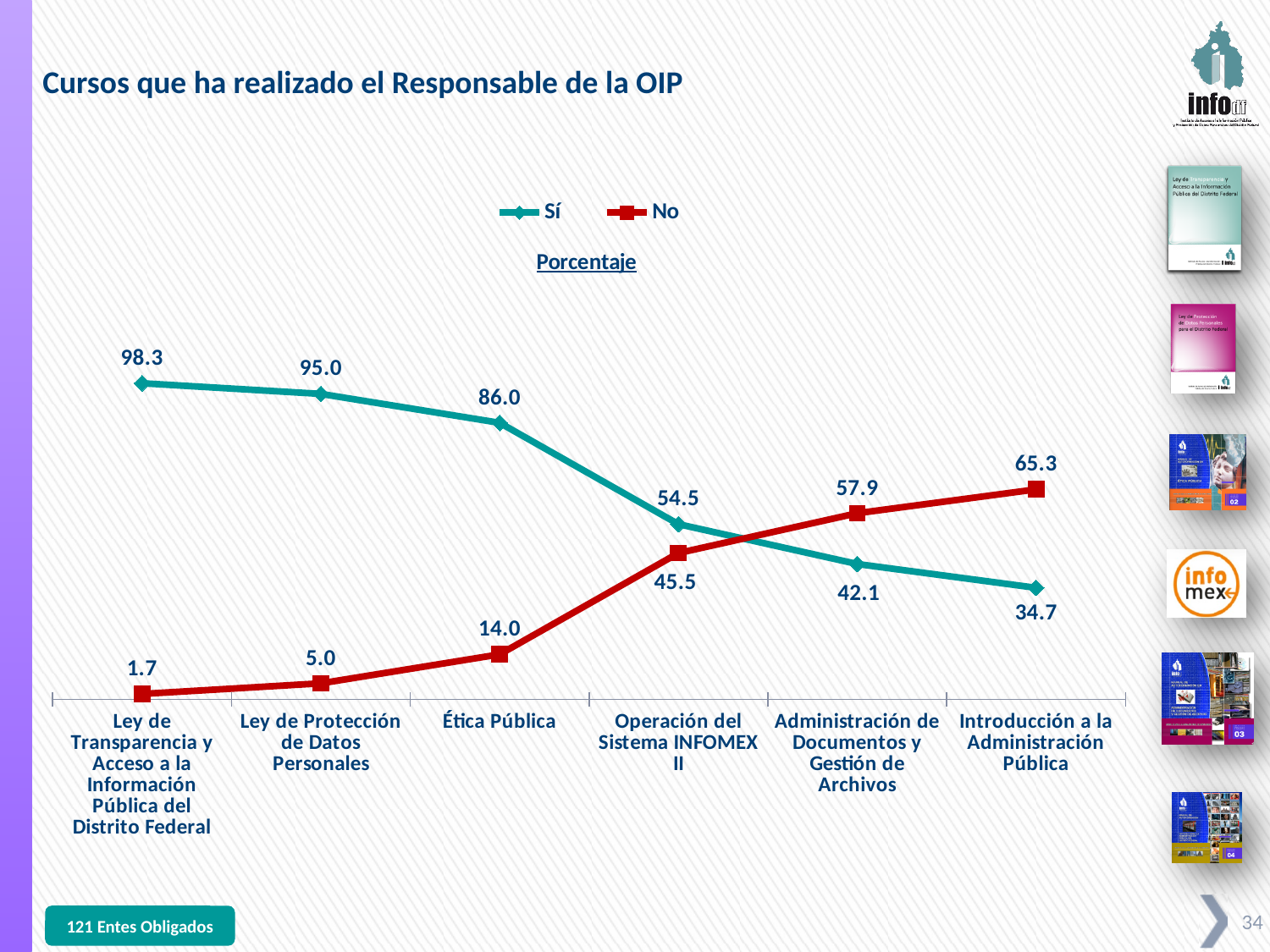
What kind of chart is shown on the slide? Line chart What is the 'Sí' value for Ética Pública? 86.0 What is the 'Sí' value for Introducción a la Administración Pública? 34.7 Which course has the highest 'Sí' value? Ley de Transparencia y Acceso a la Información Pública del Distrito Federal What is the difference between the 'Sí' and 'No' values for Ley de Protección de Datos Personales? 90.0 What is the title of the chart? Porcentaje How many series does the legend list? 2 Does the 'No' series rise or fall from left to right along the x axis? Rise How many courses are shown on the x axis? 6 For Administración de Documentos y Gestión de Archivos, which is larger, the 'Sí' value or the 'No' value? No What is the 'No' value for Operación del Sistema INFOMEX II? 45.5 Which course has the lowest 'No' value? Ley de Transparencia y Acceso a la Información Pública del Distrito Federal